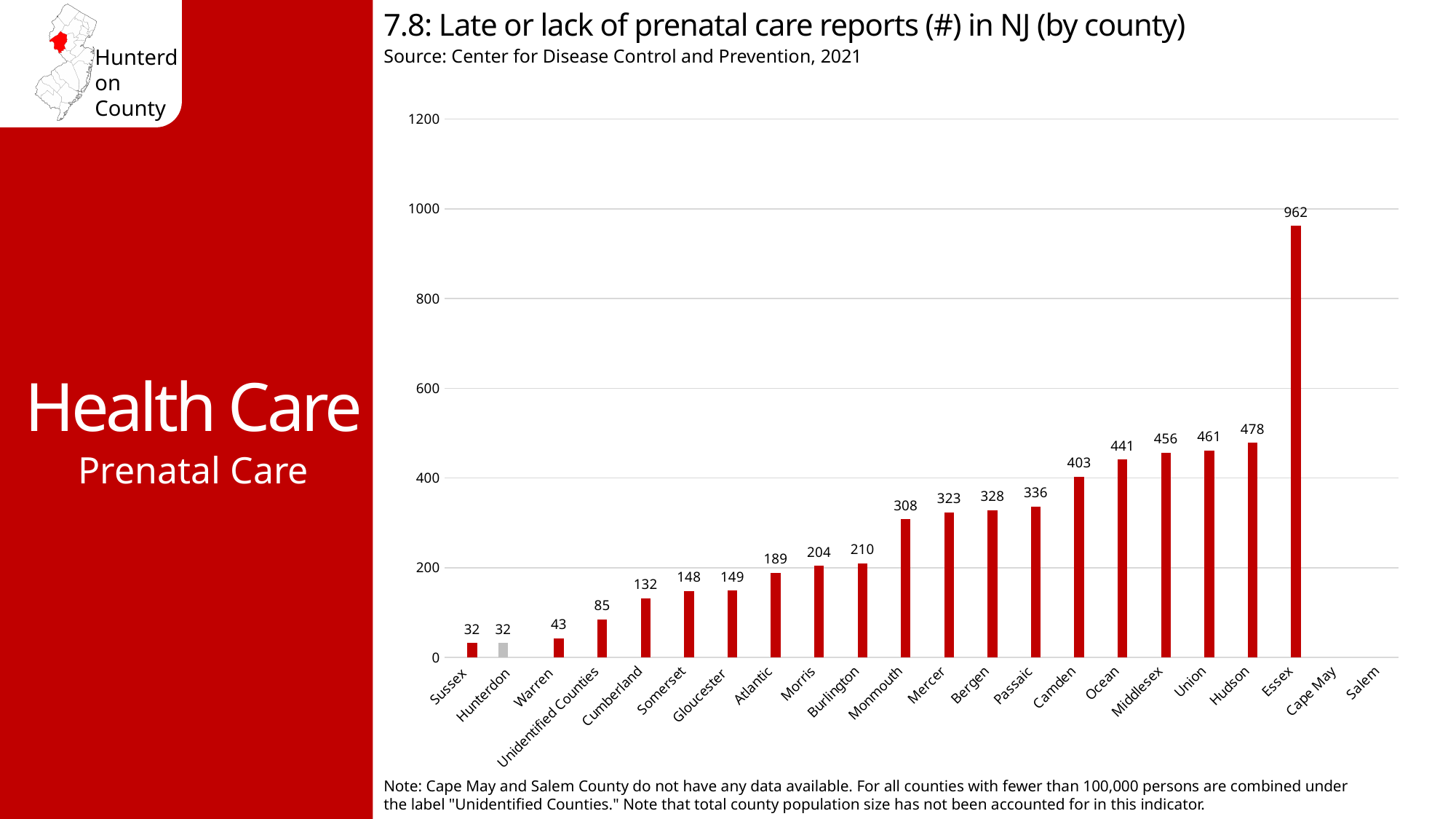
Which county has the highest number of late or lack of prenatal care reports? Essex Which has a larger value, Morris or Burlington? Burlington What kind of chart is shown on the slide? bar chart Which county's bar is shown in gray rather than red? Hunterdon What is the value shown for Cumberland? 132 What is the value shown for Essex? 962 How many counties or categories are labeled on the x axis? 22 What is the number of late or lack of prenatal care reports for Hunterdon? 32 What is the difference between the values for Camden and Passaic? 67 What is the difference between the values for Essex and Hudson? 484 What is the value shown for Unidentified Counties? 85 Is the value for Monmouth greater or less than 400? less